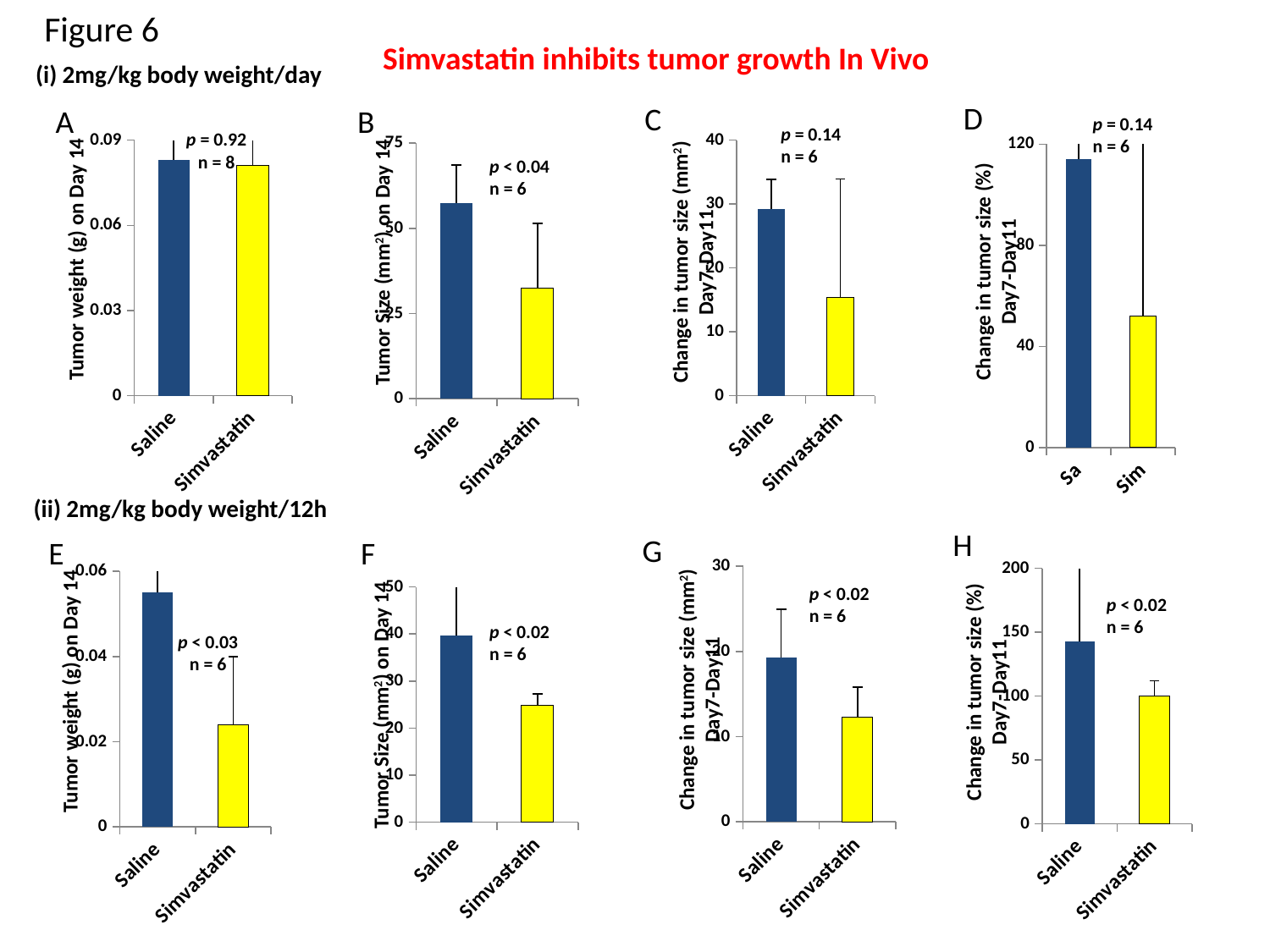
In chart D, which category has the lowest bar? Sim In chart E, is the value for Simvastatin greater or less than 0.04? less In chart H, is the value for Saline greater or less than 100? greater In chart B, is the value for Saline greater or less than 50? greater What kind of chart is chart A? bar chart How many categories are shown on the x axis of chart G? 2 In chart C, which category has the higher bar, Saline or Simvastatin? Saline